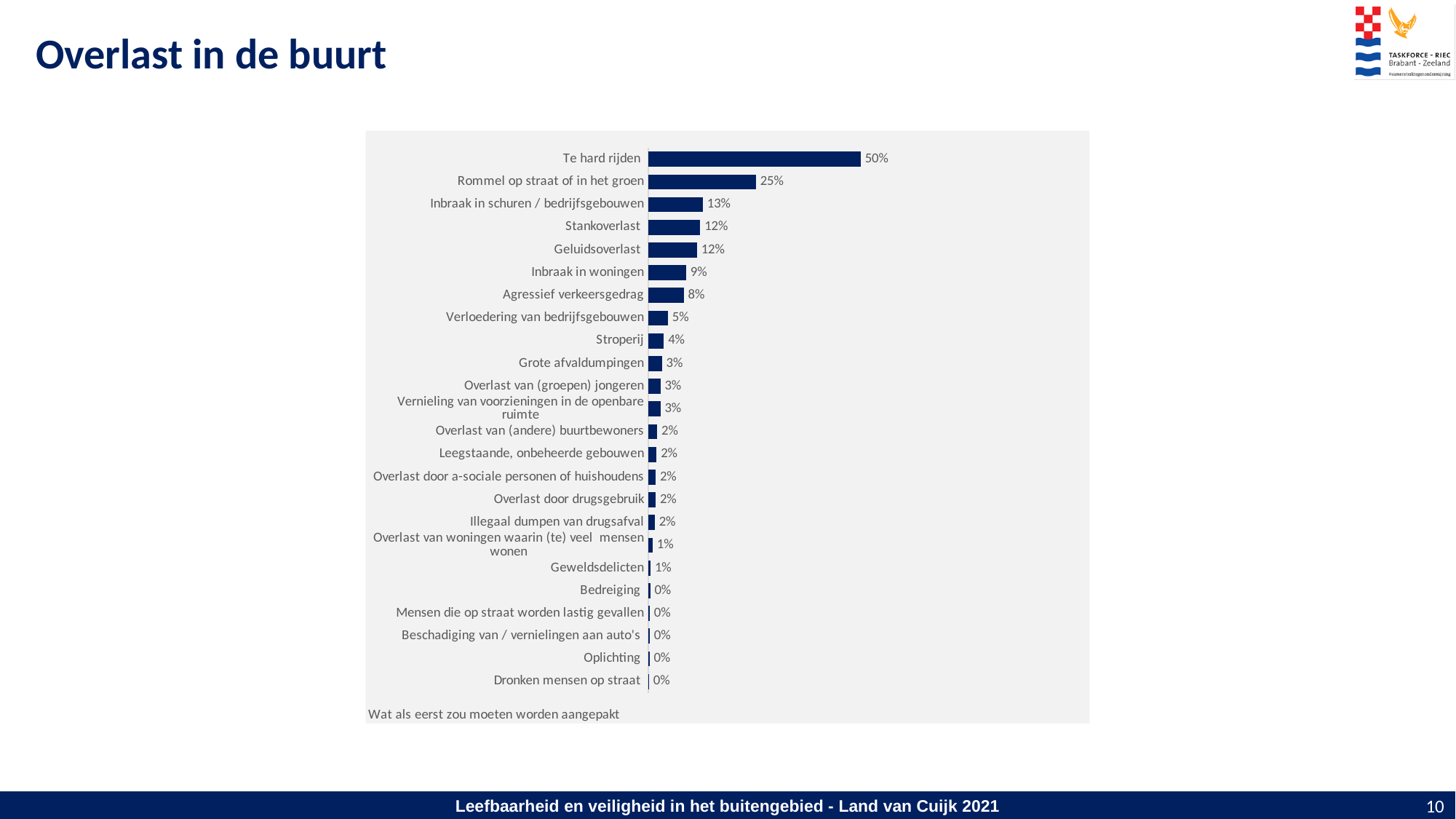
What type of chart is shown on the slide? Bar chart How many categories are shown in the chart? 24 What is the value for "Geweldsdelicten"? 1% What is the difference between "Inbraak in schuren / bedrijfsgebouwen" and "Agressief verkeersgedrag"? 5% What is the value for "Stroperij"? 4% Which is larger: the value for "Inbraak in woningen" or the value for "Verloedering van bedrijfsgebouwen"? Inbraak in woningen What is the difference between the values for "Te hard rijden" and "Rommel op straat of in het groen"? 25% What is the caption text shown below the chart? Wat als eerst zou moeten worden aangepakt Which category has the highest value in the chart? Te hard rijden What percentage is shown for "Te hard rijden"? 50% What percentage is shown for "Inbraak in woningen"? 9% What is the value for "Rommel op straat of in het groen"? 25%